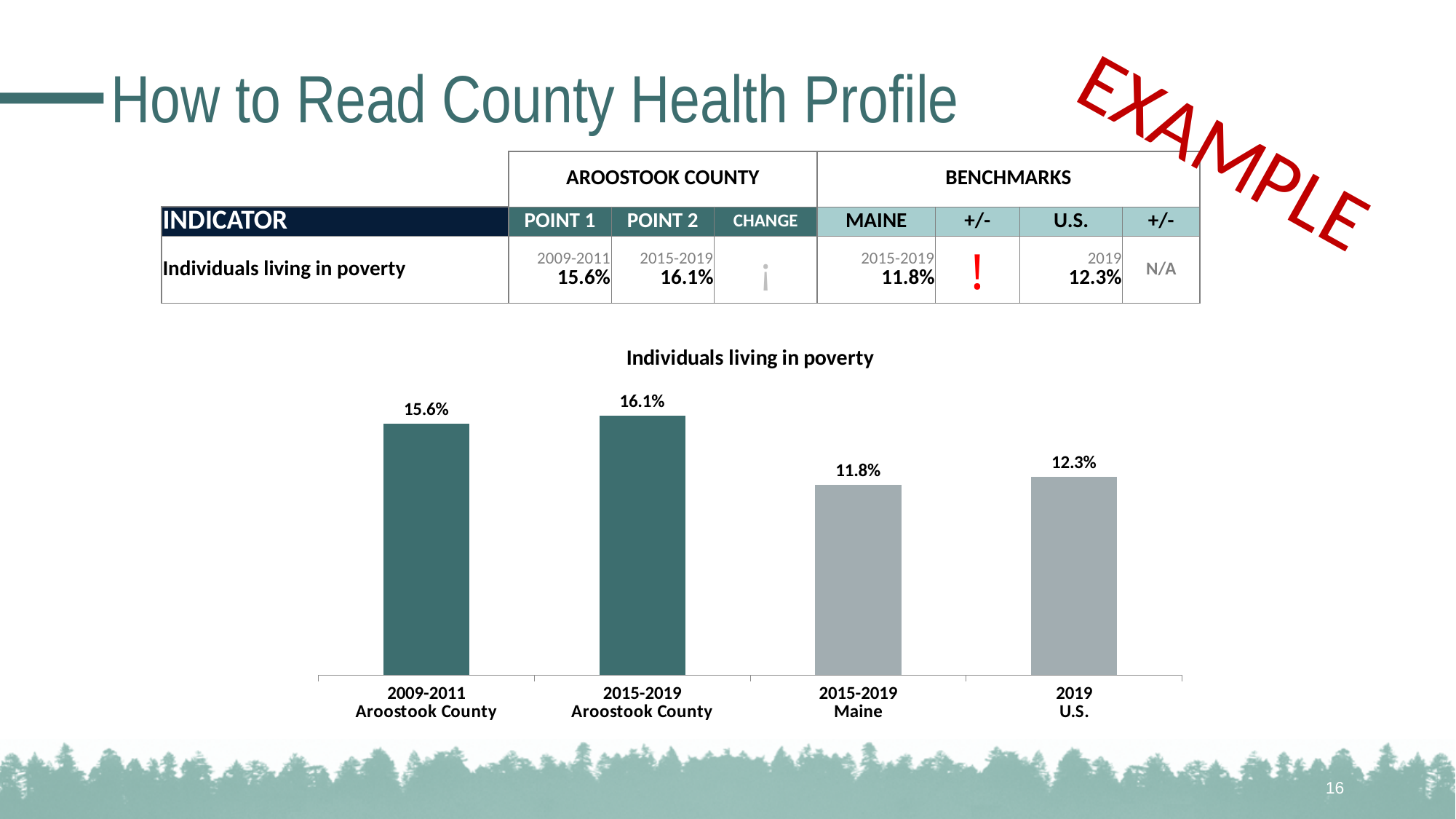
What is the value for 2019 U.S. in the chart? 12.3% What is the title of the chart? Individuals living in poverty What type of chart is shown on the slide? Bar chart Which category has the highest value in the chart? 2015-2019 Aroostook County What is the difference between the 2019 U.S. value and the 2015-2019 Maine value? 0.5% Which category has the lowest value in the chart? 2015-2019 Maine What is the difference between the 2015-2019 Aroostook County value and the 2015-2019 Maine value? 4.3% Which is larger, the value for 2009-2011 Aroostook County or the value for 2019 U.S.? 2009-2011 Aroostook County How many bars are shown in the chart? 4 What is the value for 2015-2019 Aroostook County in the chart? 16.1% What is the value for 2009-2011 Aroostook County in the chart? 15.6% What is the value for 2015-2019 Maine in the chart? 11.8%